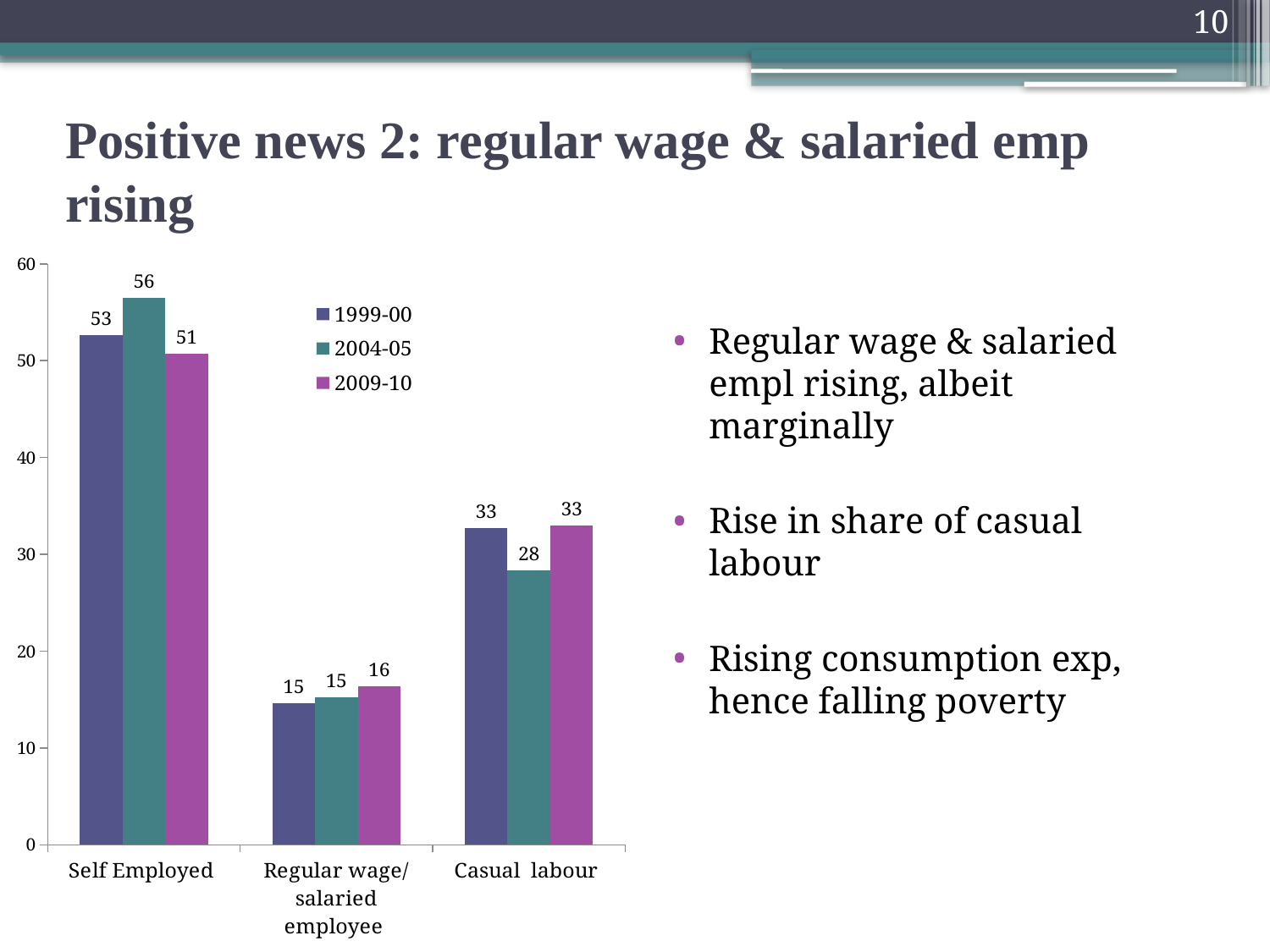
Do the values for Regular wage/ salaried employee rise or fall from 1999-00 to 2009-10? Rise Which series is shown in purple in the legend? 2009-10 What is the value for Casual labour in 2004-05? 28 What is the difference between the Self Employed values for 2004-05 and 2009-10? 5 What is the value for Regular wage/ salaried employee in 2009-10? 16 Which category has the highest value in 1999-00? Self Employed How many categories are shown on the x axis? 3 What kind of chart is shown on the slide? Bar chart Which category has the lowest value in 2009-10? Regular wage/ salaried employee Which is larger: the Casual labour value for 1999-00 or for 2004-05? 1999-00 What is the value for Self Employed in 2004-05? 56 How many series does the legend list? 3